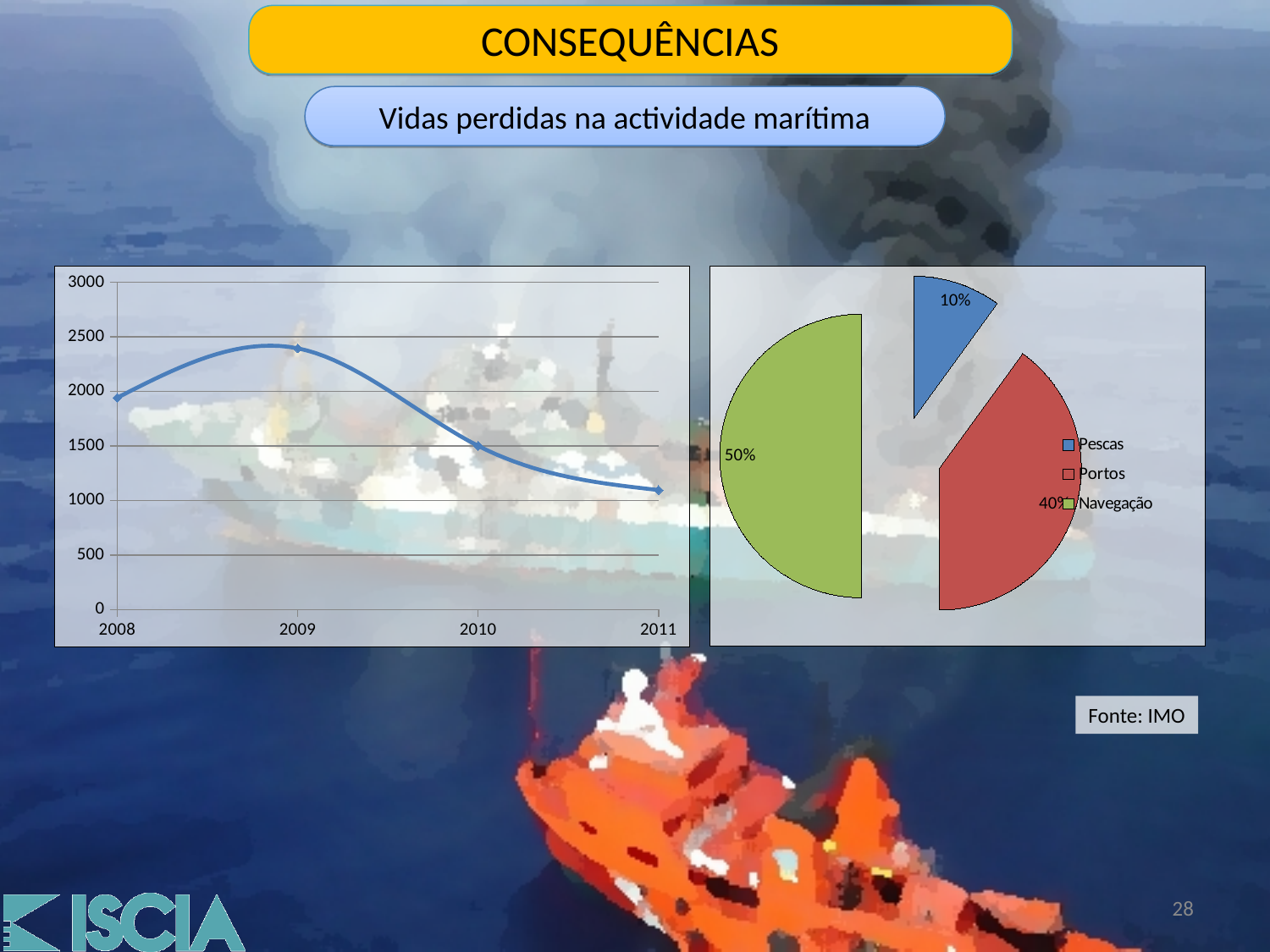
In the pie chart on the right, which category has the smallest slice? Pescas In the pie chart on the right, what share does Navegação have? 50% In the pie chart on the right, what share does Pescas have? 10% In the line chart on the left, do the values rise or fall from 2009 to 2011? fall In the pie chart on the right, what share does Portos have? 40% In the line chart on the left, is the value for 2011 greater or less than 1500? less How many years are plotted on the x axis of the line chart on the left? 4 In the pie chart on the right, which category has the largest slice? Navegação In the pie chart on the right, how many percentage points larger is the Navegação share than the Pescas share? 40 percentage points In the line chart on the left, which year has the highest value? 2009 How many categories does the legend of the pie chart on the right list? 3 What kind of chart is the chart on the left of the slide? Line chart